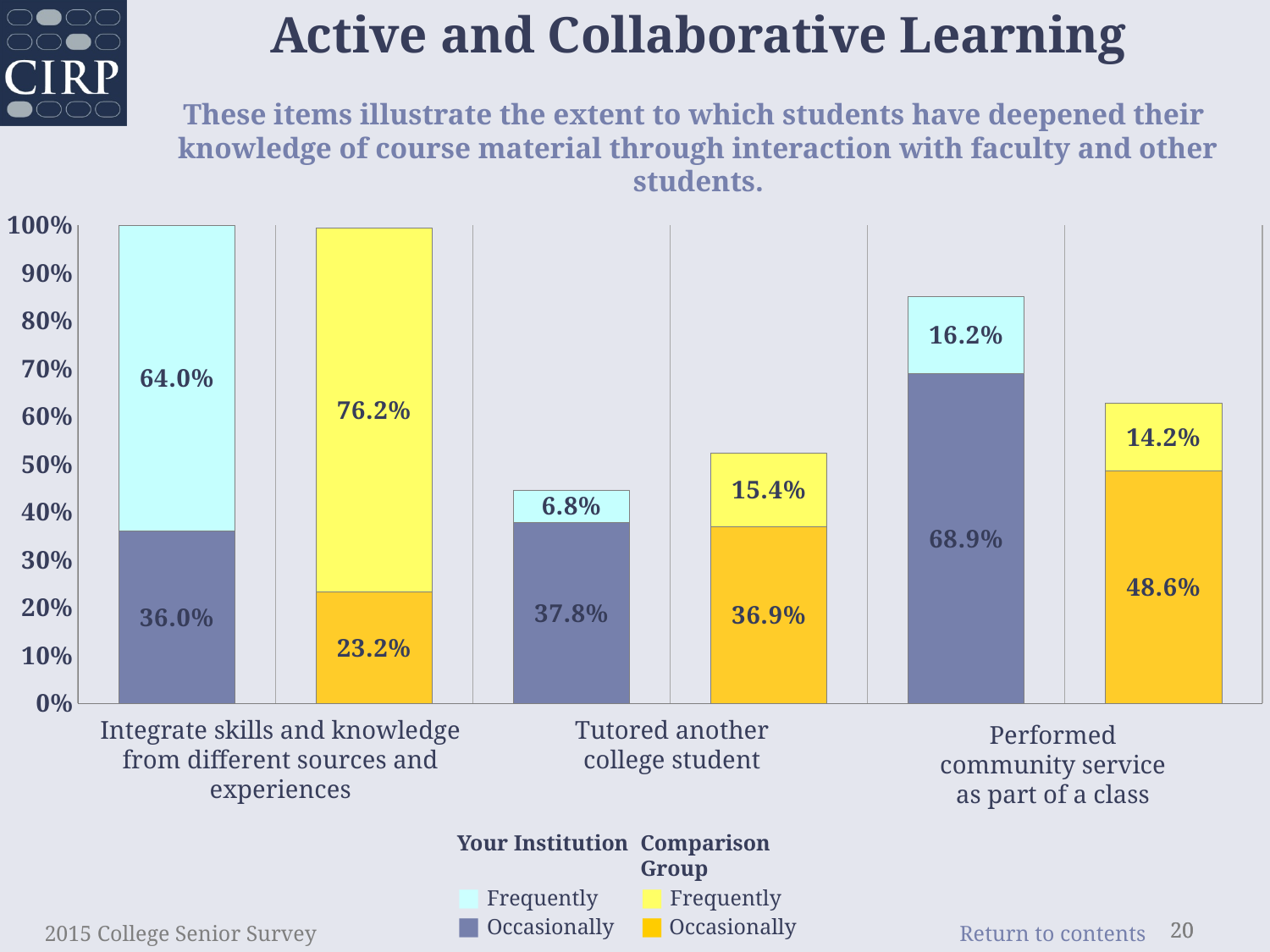
What is the difference between the Comparison Group 'Frequently' value and the Your Institution 'Frequently' value for 'Integrate skills and knowledge from different sources and experiences'? 12.2% How many entries does the legend list? 4 What kind of chart is shown on the slide? Stacked bar chart Which is larger for 'Performed community service as part of a class': the 'Occasionally' value for Your Institution or for the Comparison Group? Your Institution What is the total of the Your Institution stacked bar for 'Tutored another college student'? 44.6% What percentage of students at Your Institution reported 'Frequently' integrating skills and knowledge from different sources and experiences? 64.0% What is the total of the Comparison Group stacked bar for 'Performed community service as part of a class'? 62.8% How many categories are shown on the x axis? 3 What is the 'Frequently' value for Your Institution for 'Performed community service as part of a class'? 16.2% Across all bars, which segment has the lowest printed value? Your Institution Frequently for Tutored another college student (6.8%) What is the 'Occasionally' value for the Comparison Group for 'Integrate skills and knowledge from different sources and experiences'? 23.2% What is the 'Occasionally' value for the Comparison Group for 'Tutored another college student'? 36.9%